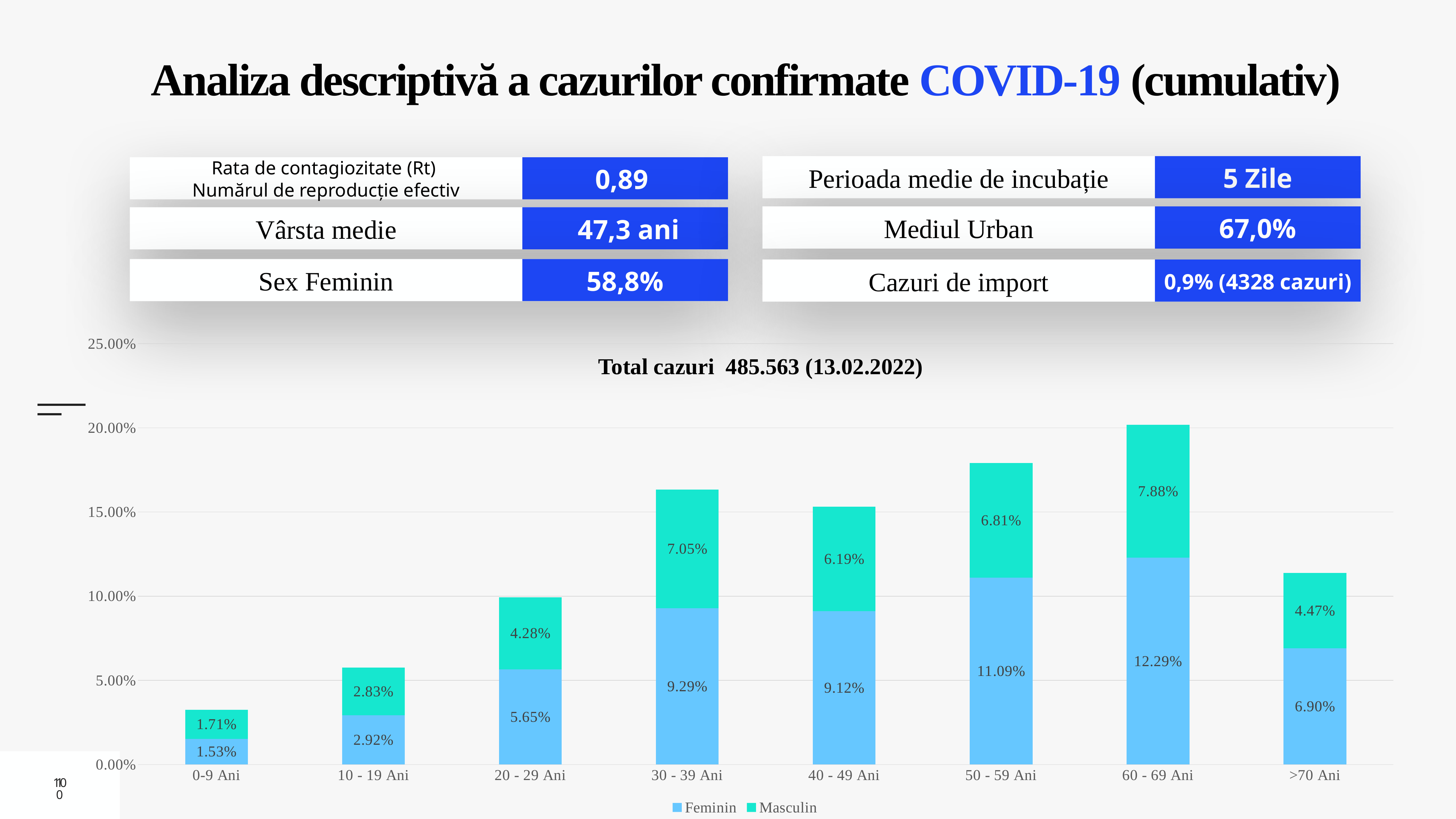
What kind of chart is shown on the slide? Stacked bar chart What is the Feminin value for the 60 - 69 Ani age group? 12.29% Which age group has the highest Feminin value? 60 - 69 Ani What is the Masculin value for the 30 - 39 Ani age group? 7.05% What is the Feminin value for the 0-9 Ani age group? 1.53% Which is larger for the 20 - 29 Ani age group, the Feminin value or the Masculin value? Feminin What is the total of the stacked bar for the 0-9 Ani age group? 3.24% How many age groups are shown on the x axis of the chart? 8 How many series does the chart legend list? 2 Which age group has the lowest Masculin value? 0-9 Ani What is the difference between the Feminin and Masculin values for the 60 - 69 Ani age group? 4.41% Which series is shown in the darker teal-green colour in the chart? Masculin